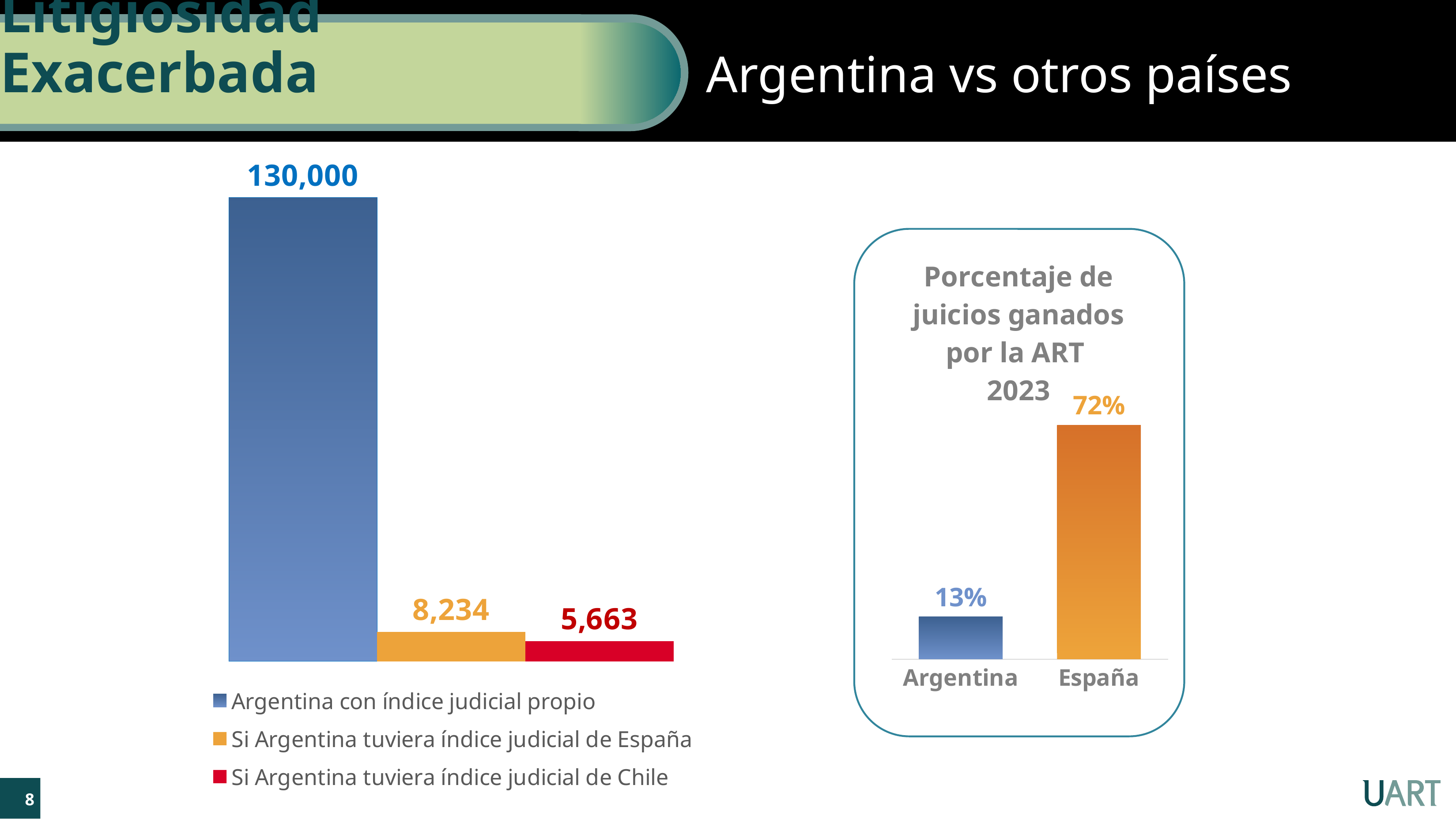
What kind of chart is the left chart? Bar chart On the chart 'Porcentaje de juicios ganados por la ART 2023', what is the value for Argentina? 13% On the left chart, what is the value for 'Si Argentina tuviera índice judicial de Chile'? 5,663 On the chart 'Porcentaje de juicios ganados por la ART 2023', how many categories are shown? 2 On the left chart, which series has the lowest value? Si Argentina tuviera índice judicial de Chile On the chart 'Porcentaje de juicios ganados por la ART 2023', which country has the higher value? España On the left chart, how many series does the legend list? 3 On the left chart, what is the value for 'Si Argentina tuviera índice judicial de España'? 8,234 On the chart 'Porcentaje de juicios ganados por la ART 2023', what is the value for España? 72% On the chart 'Porcentaje de juicios ganados por la ART 2023', what is the difference between España and Argentina? 59% On the left chart, what is the value for 'Argentina con índice judicial propio'? 130,000 On the left chart, what is the difference between the values for the España scenario and the Chile scenario? 2,571